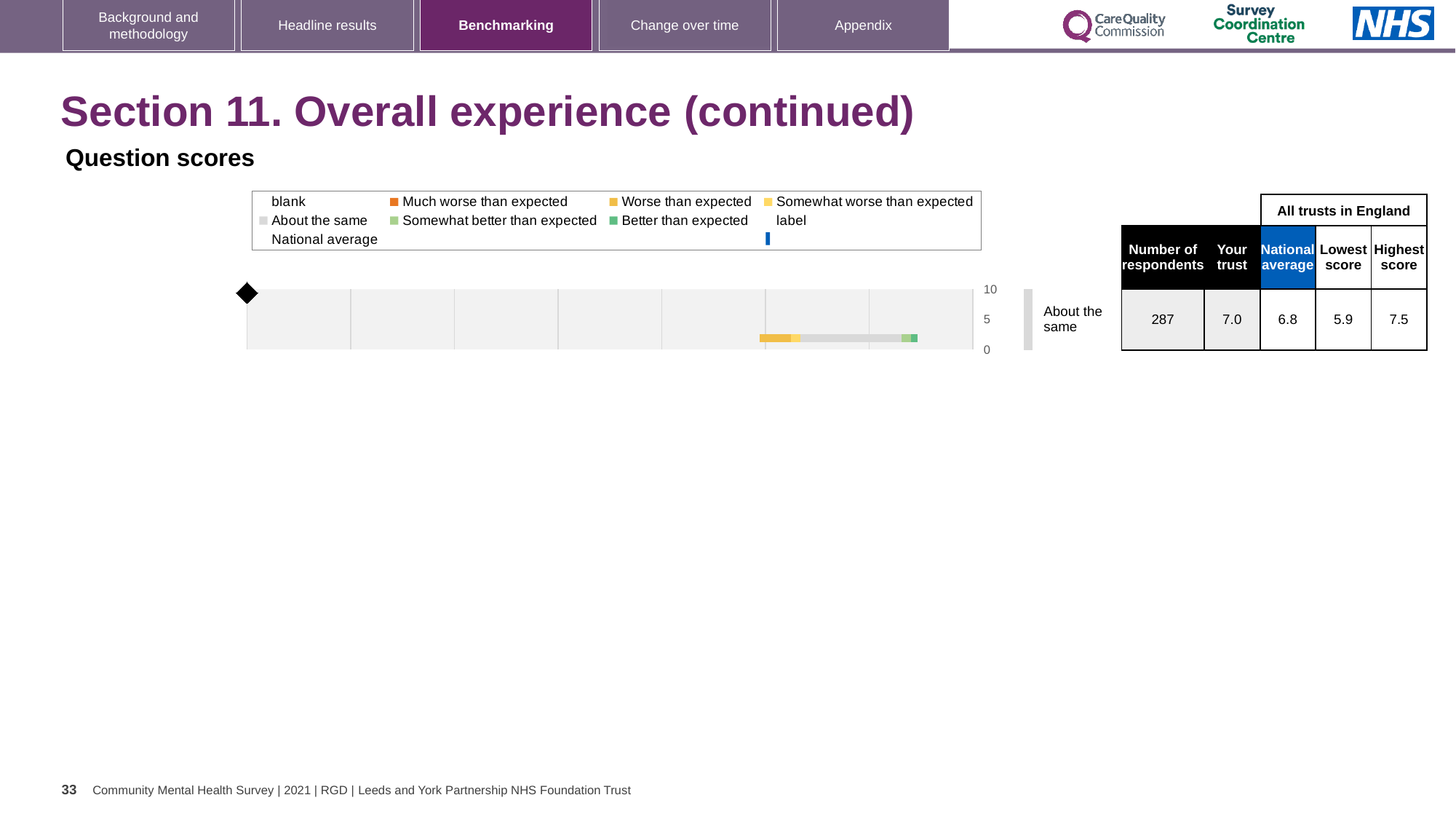
What is the highest score among all trusts in England for the plotted question? 7.5 Is the 'Your trust' score for the plotted question greater or less than 5? greater What is the national average score for the plotted question? 6.8 How many respondents are recorded for the plotted question? 287 What is the difference between the highest score and the lowest score for the plotted question? 1.6 Which is larger for the plotted question: the 'Your trust' score or the national average? Your trust What kind of chart is shown under 'Question scores'? bar chart What is the highest value shown on the chart's axis? 10 What is the lowest score among all trusts in England for the plotted question? 5.9 What is the 'Your trust' score for the plotted question? 7.0 What benchmark category label is shown for the plotted question? About the same How many question rows are plotted in the chart? 1